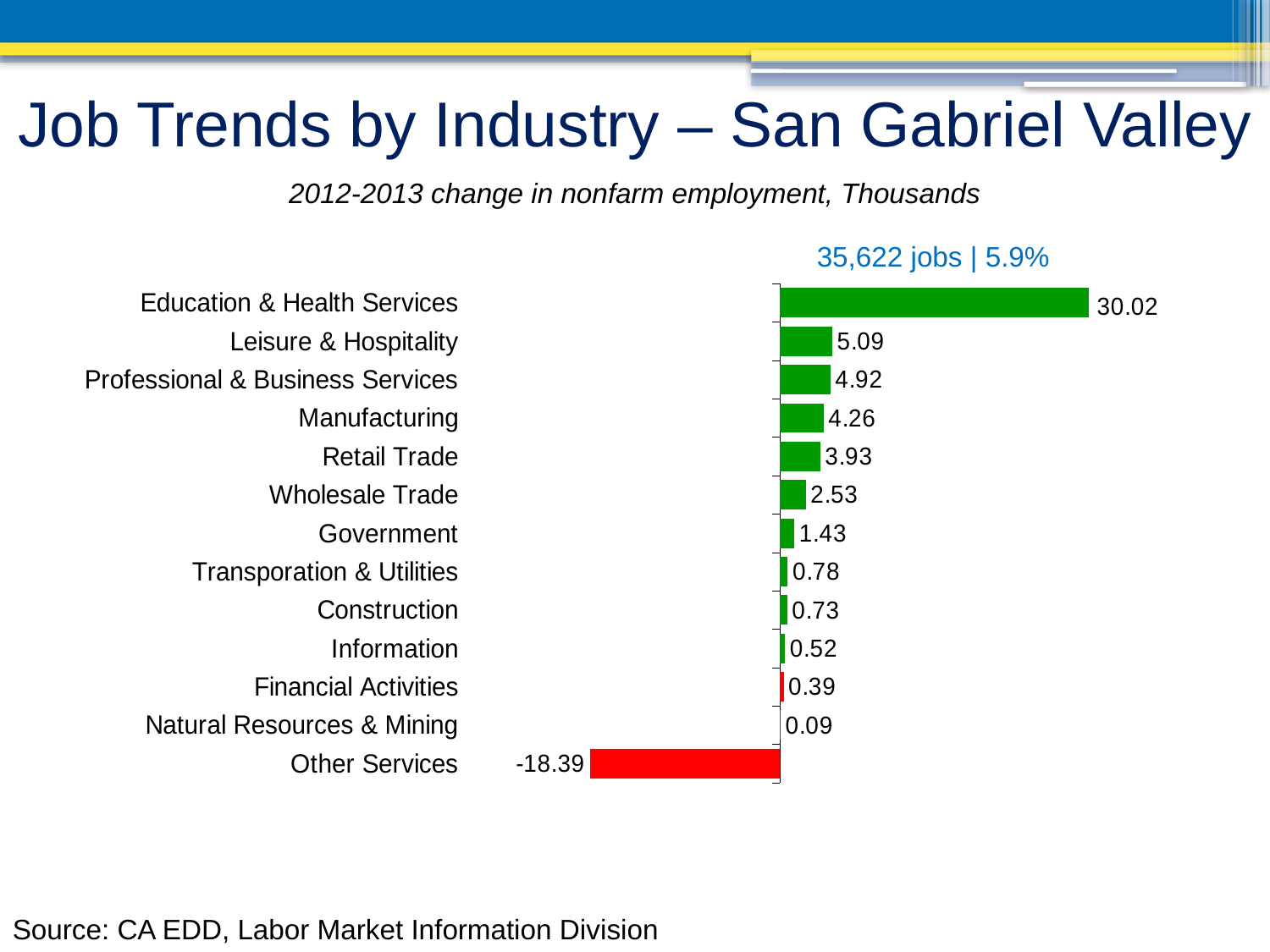
How many industries are shown in the chart? 13 Which industry has the lowest value? Other Services Which industry has the highest value? Education & Health Services What is the value for Natural Resources & Mining? 0.09 What is the difference between the values for Education & Health Services and Other Services? 48.41 What is the difference between the values for Leisure & Hospitality and Professional & Business Services? 0.17 What is the value for Education & Health Services? 30.02 What is the value for Manufacturing? 4.26 What is the value for Other Services? -18.39 What kind of chart is shown on the slide? Bar chart Which is larger, the value for Retail Trade or the value for Wholesale Trade? Retail Trade What total jobs figure and percentage are shown above the chart? 35,622 jobs | 5.9%